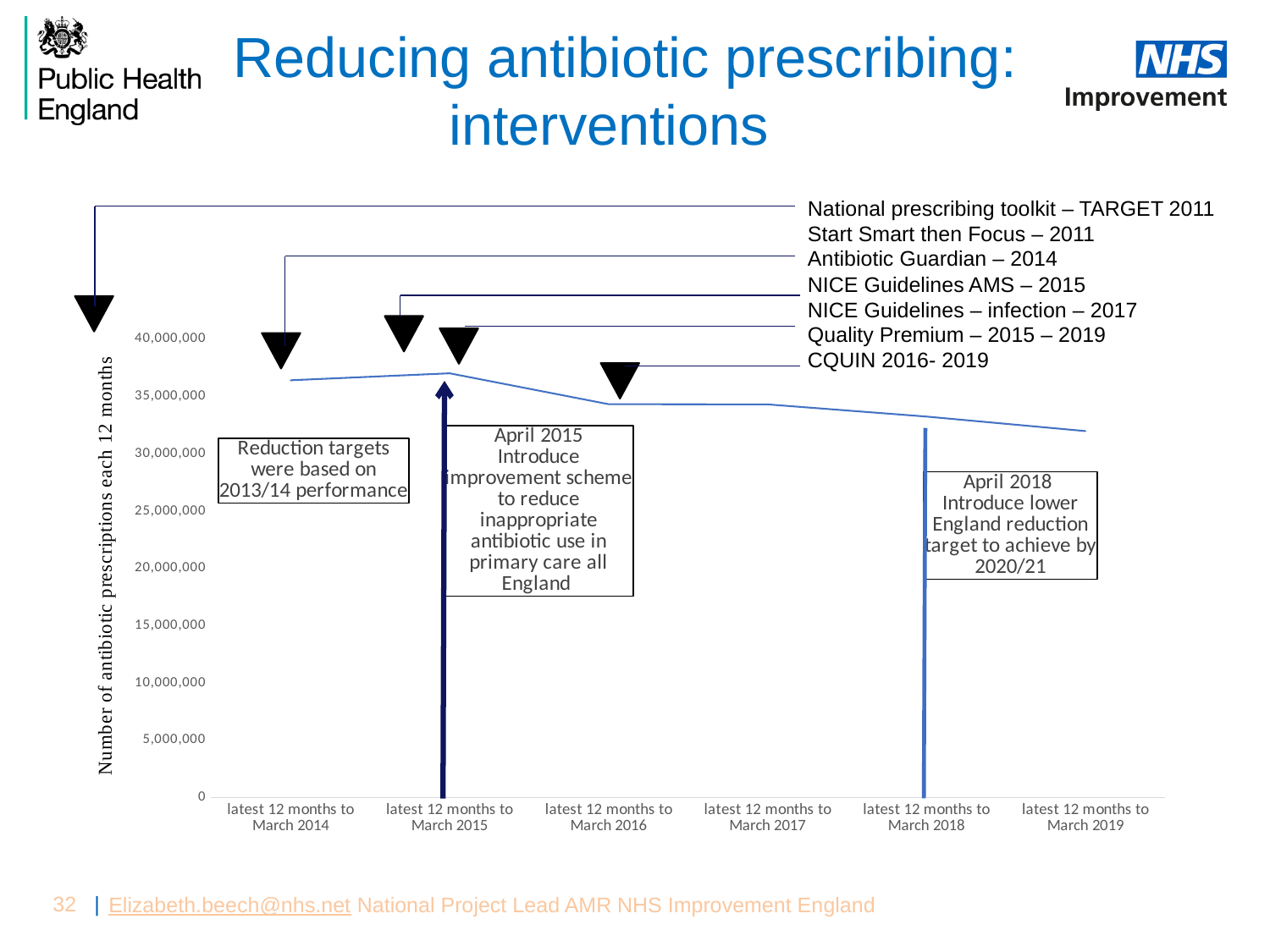
Is the value for the latest 12 months to March 2019 greater or less than 35,000,000? less Which is larger: the value for the latest 12 months to March 2015 or the latest 12 months to March 2019? latest 12 months to March 2015 Is the value for the latest 12 months to March 2017 greater or less than 30,000,000? greater Which period has the lowest number of antibiotic prescriptions in the chart? latest 12 months to March 2019 Overall, do the values rise or fall from the latest 12 months to March 2015 to the latest 12 months to March 2019? fall What is the label on the y axis of the chart? Number of antibiotic prescriptions each 12 months Is the value for the latest 12 months to March 2014 greater or less than 40,000,000? less What is the highest value shown on the y axis of the chart? 40,000,000 What kind of chart is shown on the slide? line chart How many time periods are plotted along the x axis of the chart? 6 Which period has the highest number of antibiotic prescriptions in the chart? latest 12 months to March 2015